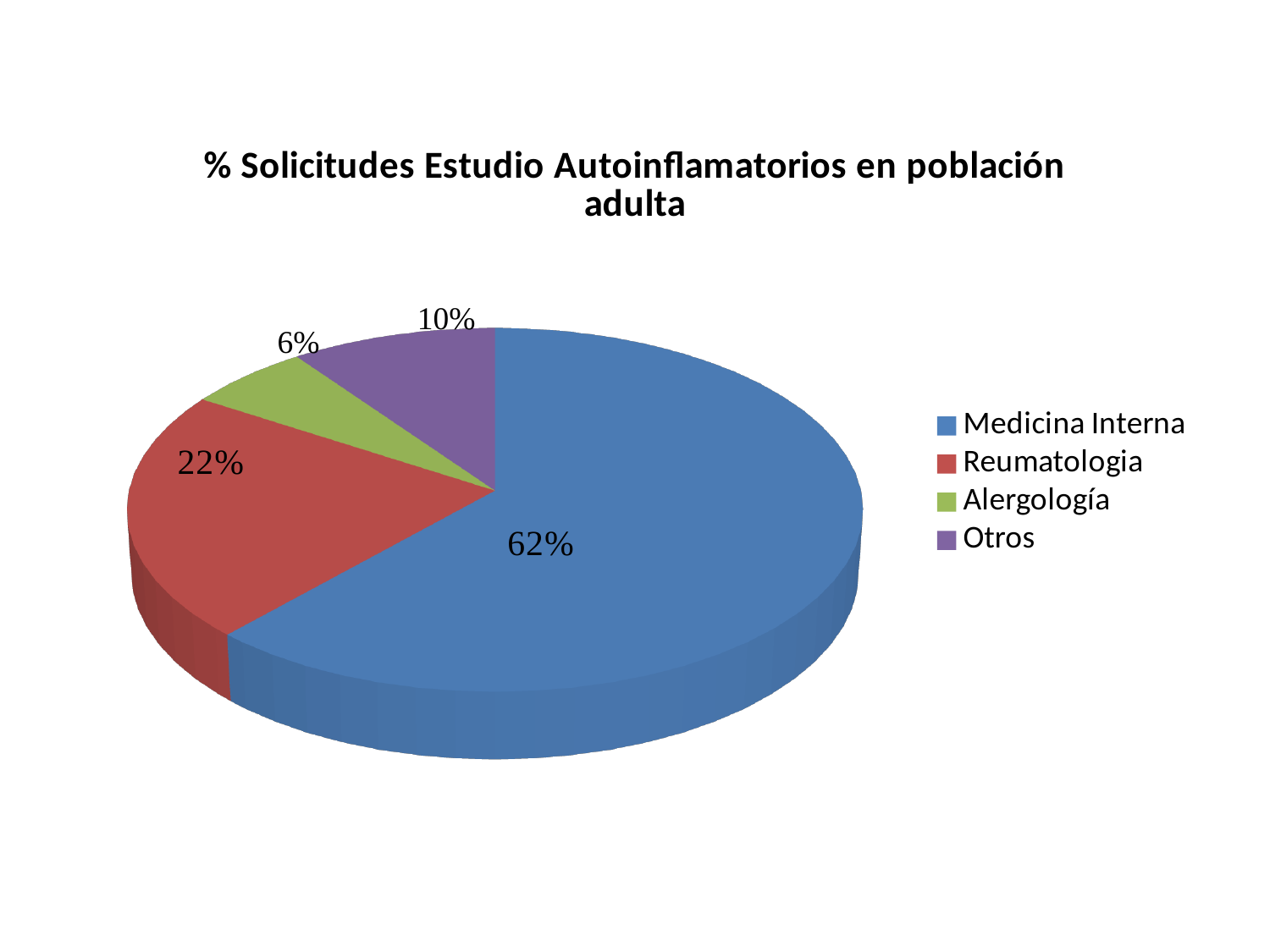
Which colour represents Reumatologia in the legend? Red How many categories are shown in the pie chart? 4 What type of chart is shown on the slide? Pie chart What percentage of the pie corresponds to Otros? 10% What percentage of the pie corresponds to Reumatologia? 22% Which category has the smallest share of the pie? Alergología What is the difference in percentage points between Medicina Interna and Reumatologia? 40 What is the title of the chart? % Solicitudes Estudio Autoinflamatorios en población adulta What percentage of the pie corresponds to Medicina Interna? 62% What percentage of the pie corresponds to Alergología? 6% Which has a larger share, Otros or Alergología? Otros Which category has the largest share of the pie? Medicina Interna